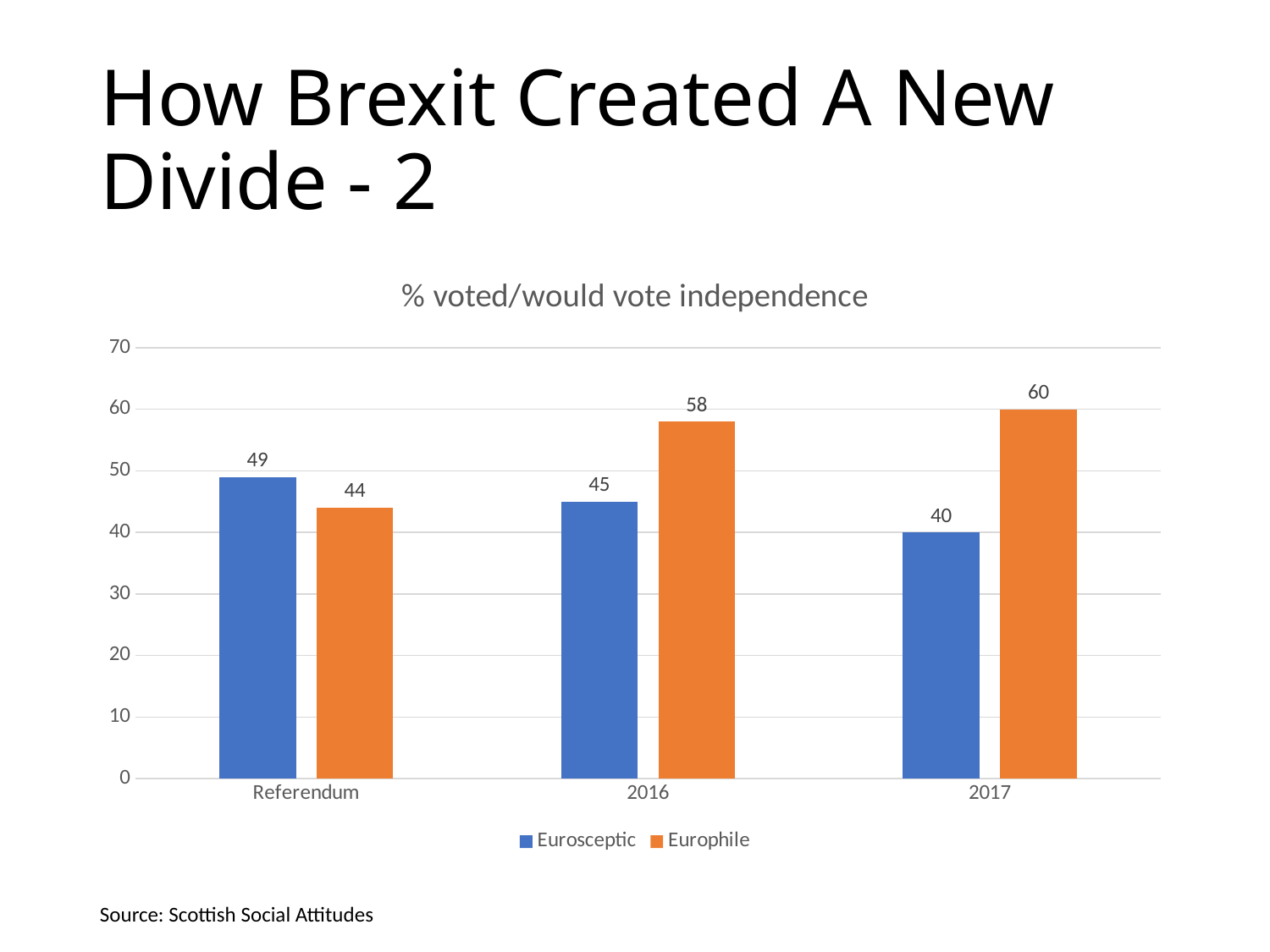
For Referendum, which series has the larger value, Eurosceptic or Europhile? Eurosceptic What is the difference between the Europhile and Eurosceptic values for 2017? 20 How many series does the legend list? 2 What kind of chart is shown on the slide? bar chart What is the Eurosceptic value for Referendum? 49 Which category has the lowest Eurosceptic value? 2017 Is the Eurosceptic value for 2016 greater or less than 50? less How many categories are shown on the x axis? 3 Which category has the highest Europhile value? 2017 Do the Eurosceptic values rise or fall from Referendum to 2017? fall What is the Europhile value for 2016? 58 What is the Europhile value for 2017? 60